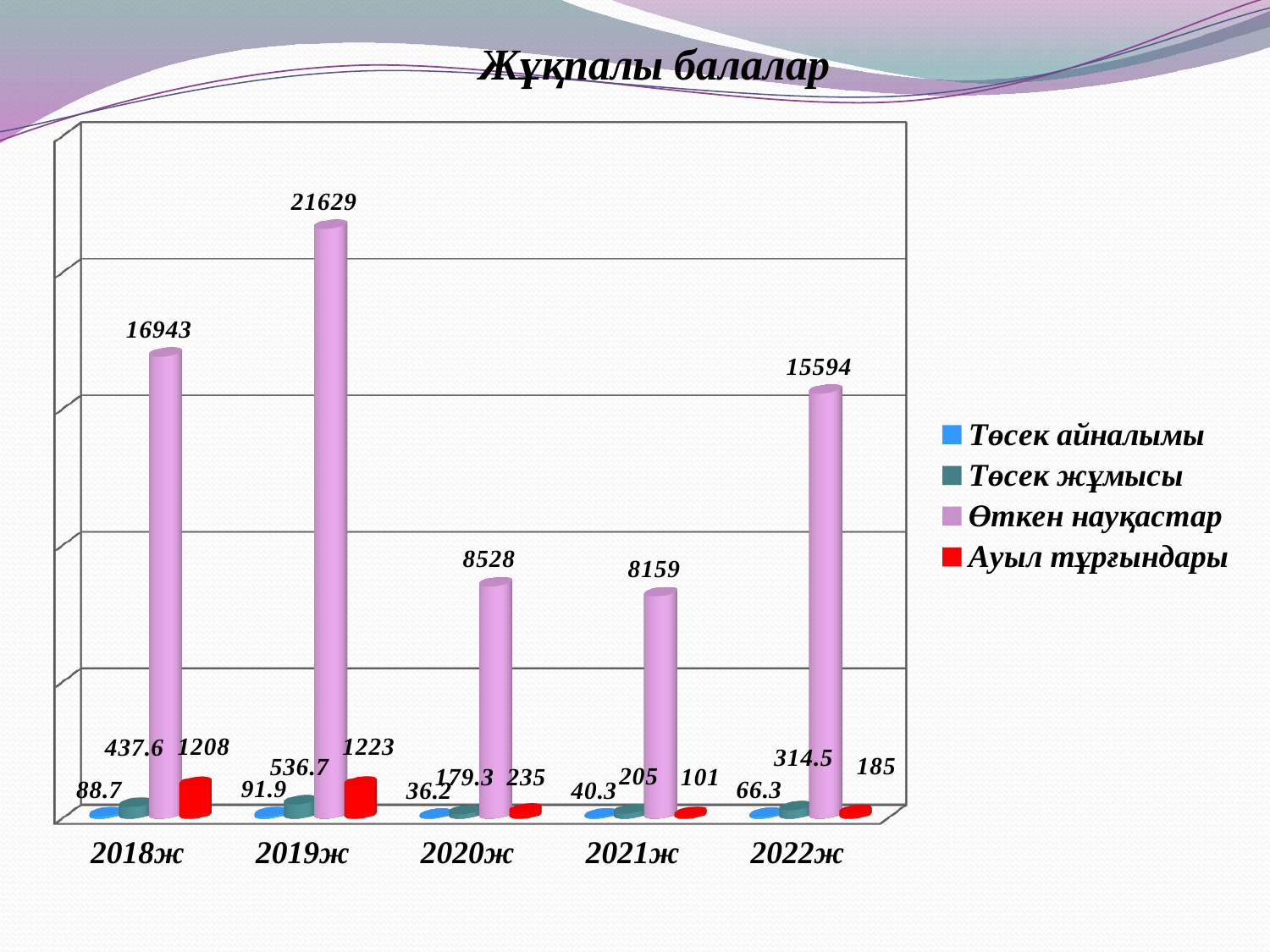
In which year is Ауыл тұрғындары lowest? 2021ж What is the value of Төсек жұмысы for 2022ж? 314.5 Which is larger: Өткен науқастар in 2020ж or in 2021ж? 2020ж What is the difference between Өткен науқастар in 2019ж and 2018ж? 4686 What is the value of Төсек айналымы for 2020ж? 36.2 How many years are shown on the x axis? 5 In which year is Өткен науқастар highest? 2019ж How many series does the legend list? 4 What is the title of the chart? Жұқпалы балалар What is the value of Ауыл тұрғындары for 2021ж? 101 What is the value of Өткен науқастар for 2019ж? 21629 What kind of chart is shown on the slide? Bar chart